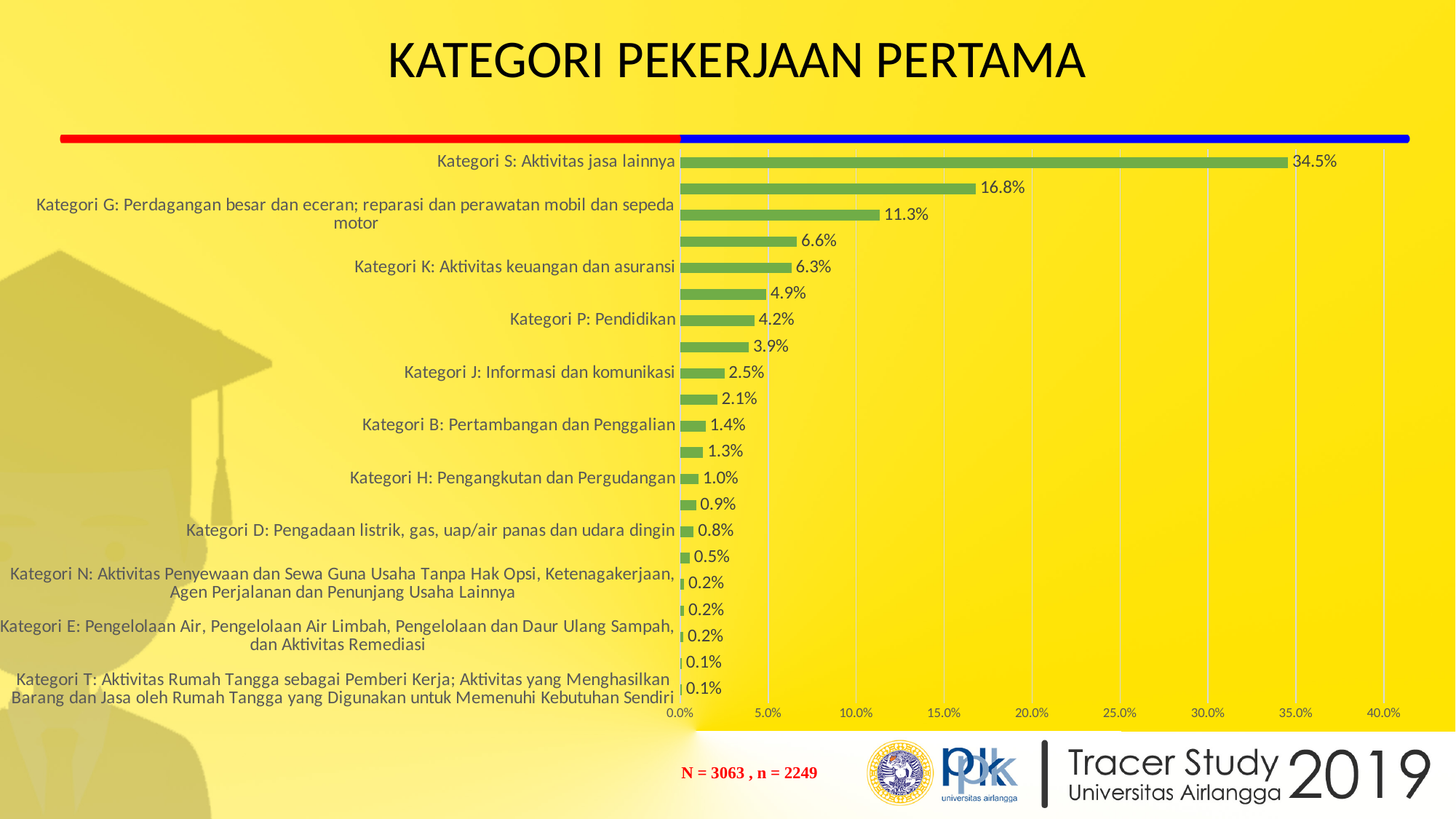
What is the value for Kategori S: Aktivitas jasa lainnya? 34.5% Which is larger, the value for Kategori K: Aktivitas keuangan dan asuransi or Kategori P: Pendidikan? Kategori K: Aktivitas keuangan dan asuransi What is the difference between the values for Kategori S: Aktivitas jasa lainnya and Kategori G: Perdagangan besar dan eceran; reparasi dan perawatan mobil dan sepeda motor? 23.2% Which category has the highest value? Kategori S: Aktivitas jasa lainnya What is the value for Kategori P: Pendidikan? 4.2% Is the value for Kategori G: Perdagangan besar dan eceran; reparasi dan perawatan mobil dan sepeda motor greater or less than 10.0%? greater What is the value for Kategori D: Pengadaan listrik, gas, uap/air panas dan udara dingin? 0.8% What is the value for Kategori H: Pengangkutan dan Pergudangan? 1.0% What is the value for Kategori K: Aktivitas keuangan dan asuransi? 6.3% What is the title of the chart? KATEGORI PEKERJAAN PERTAMA What kind of chart is shown on the slide? bar chart What is the value for Kategori J: Informasi dan komunikasi? 2.5%